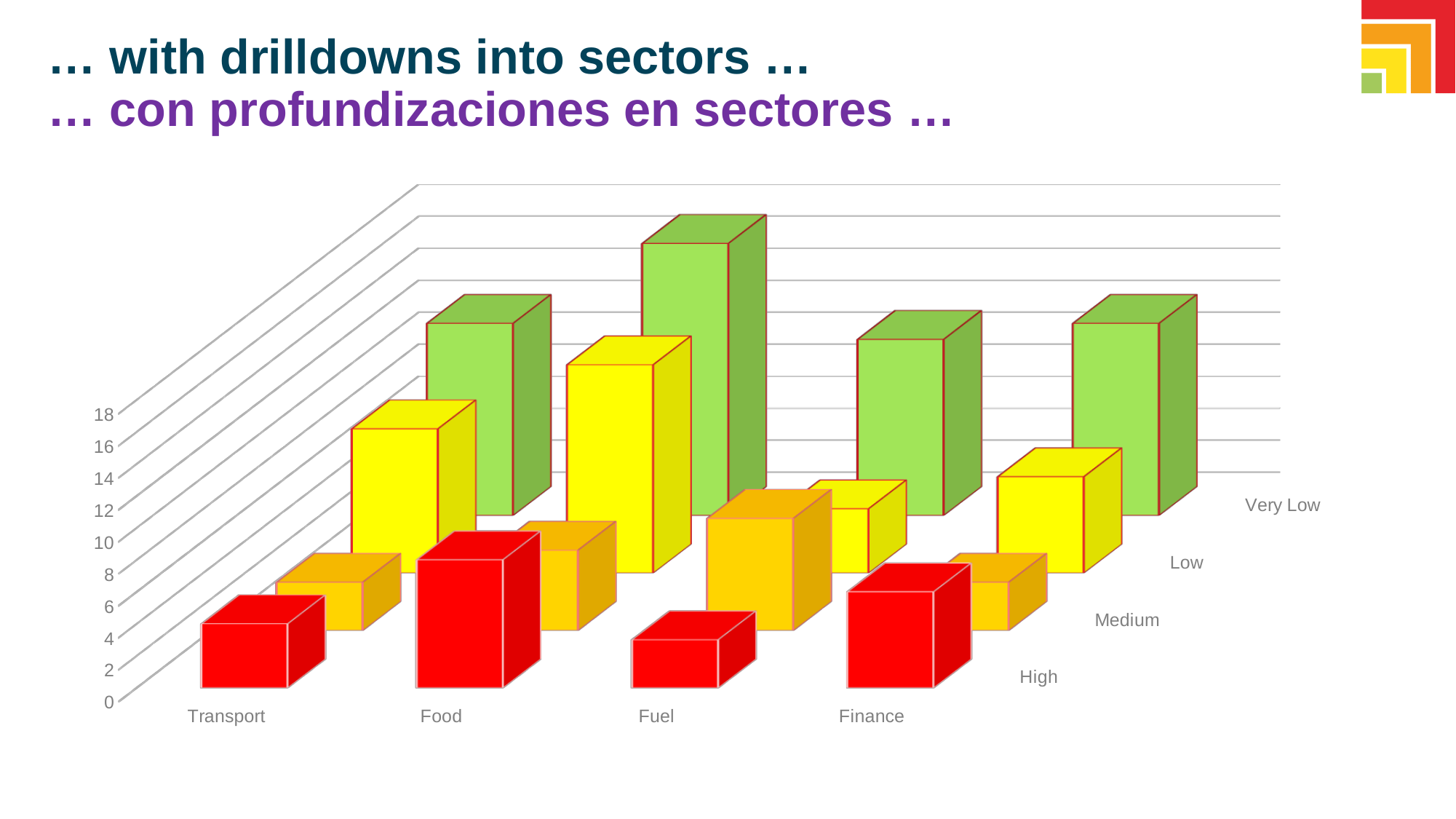
In the High series, which is larger: Food or Transport? Food What colour are the bars of the Very Low series? green In the Very Low series, which is larger: Food or Finance? Food How many sector categories are shown along the x axis of the chart? 4 What kind of chart is shown on the slide? bar chart In the Medium series, which is larger: Fuel or Transport? Fuel What is the highest value shown on the vertical axis of the chart? 18 Which sector has the tallest bar in the Very Low series? Food How many series (High, Medium, Low, Very Low) does the chart plot? 4 What colour are the bars of the High series? red Which sector has the tallest bar overall in the chart? Food